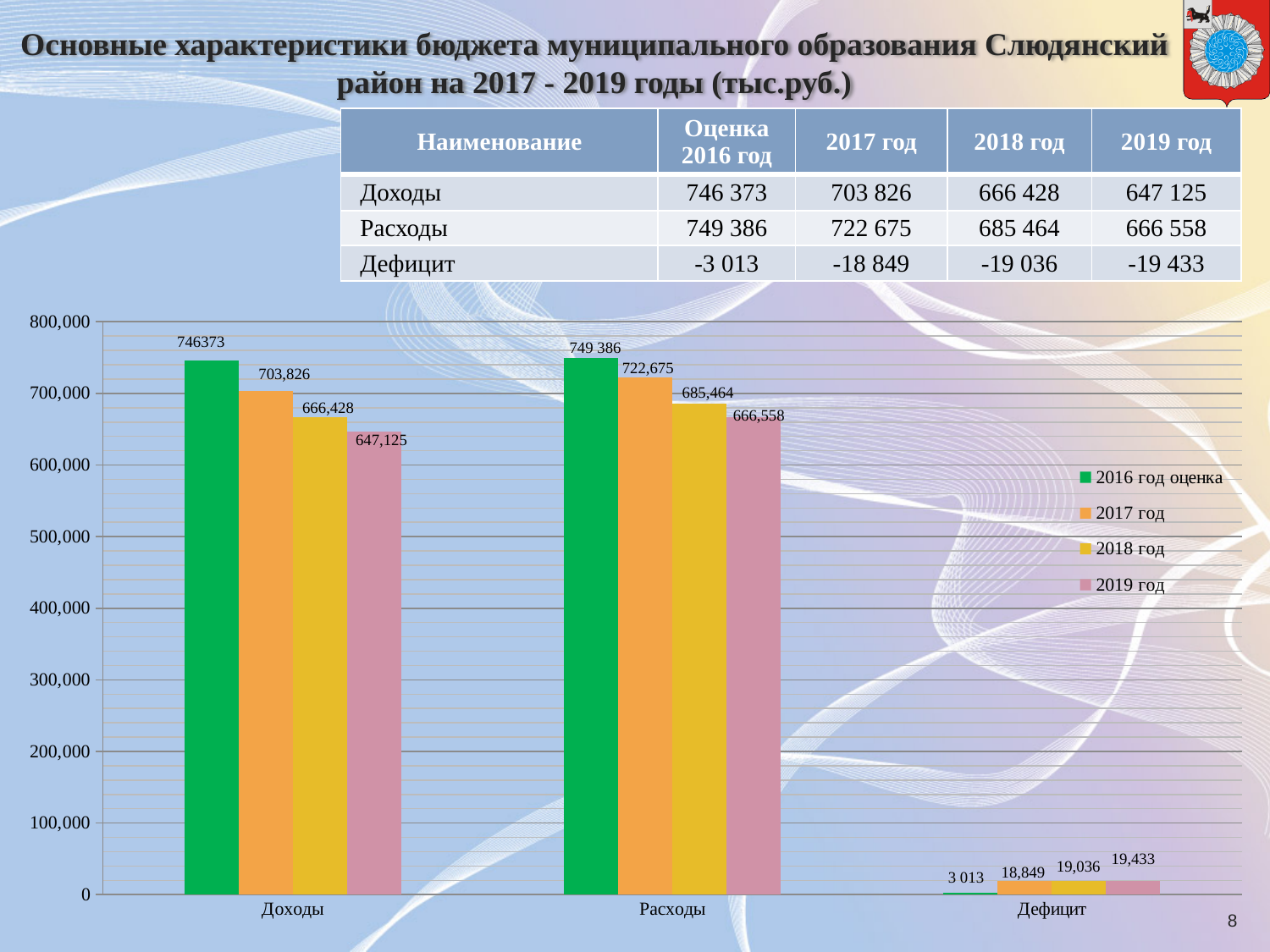
What is the value of the 2019 год bar for Дефицит in the chart? 19,433 Is the 2019 год bar for Доходы greater or less than 600,000? greater What is the value of the 2017 год bar for Доходы in the chart? 703,826 Do the Доходы bars rise or fall from 2016 год оценка to 2019 год? fall Which series has the lowest bar in the Расходы category? 2019 год What kind of chart is shown on the slide? bar chart What is the difference between the 2019 год bars for Расходы (666,558) and Доходы (647,125)? 19,433 Which series has the highest bar in the Доходы category? 2016 год оценка How many categories are shown on the x axis of the chart? 3 How many series does the chart legend list? 4 What is the value of the 2018 год bar for Расходы in the chart? 685,464 Which is larger: the 2017 год bar for Доходы or the 2017 год bar for Расходы? Расходы